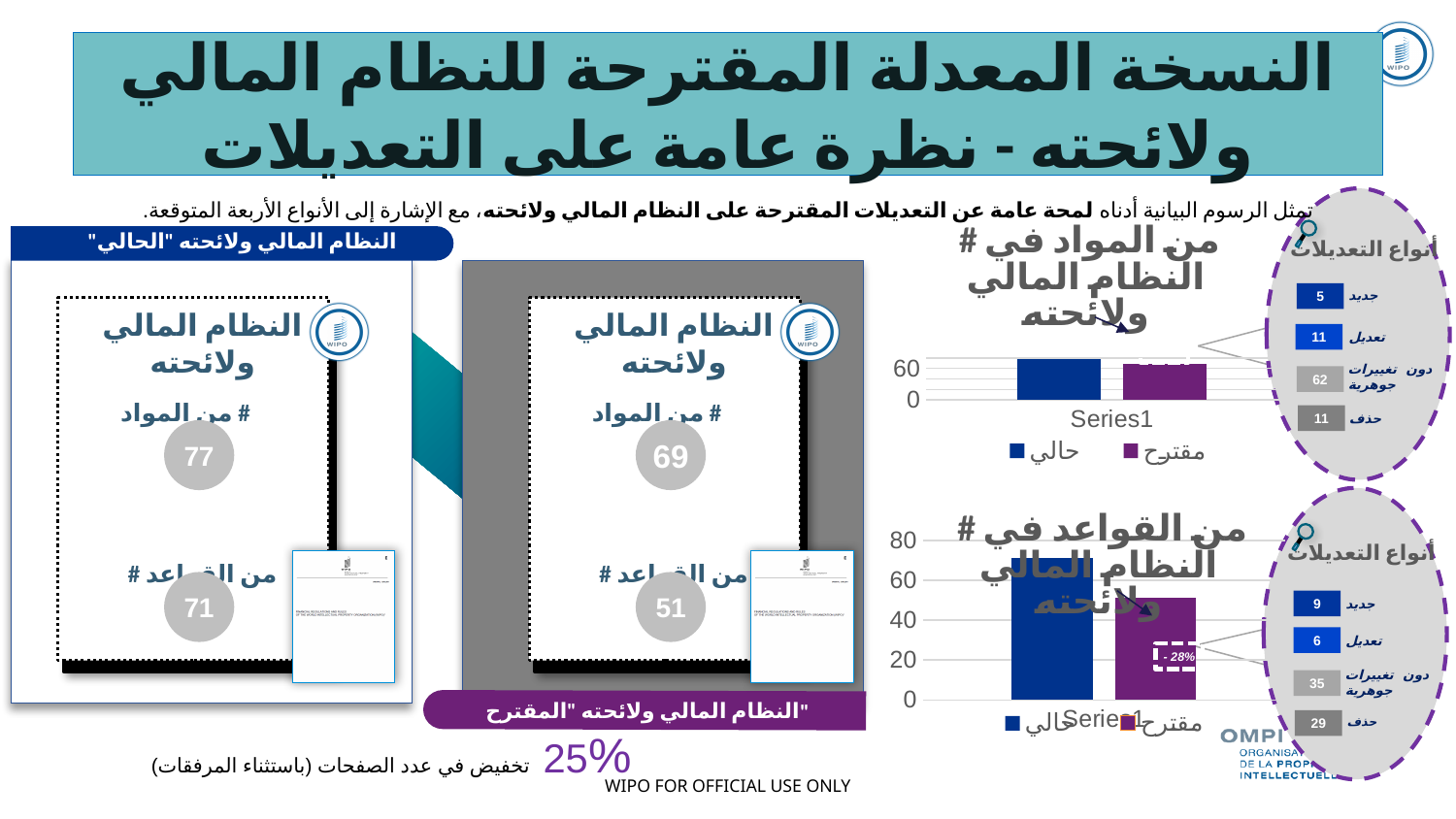
In the bottom chart (# من القواعد في النظام المالي ولائحته), what percentage change is labelled on the مقترح bar? -28% In the bottom chart (# من القواعد في النظام المالي ولائحته), is the value for حالي greater or less than 60? greater In the bottom chart (# من القواعد في النظام المالي ولائحته), which series has the taller bar, حالي or مقترح? حالي In the bottom chart (# من القواعد في النظام المالي ولائحته), what colour is the bar for حالي? blue In the bottom chart (# من القواعد في النظام المالي ولائحته), how many series does the legend list? 2 In the top chart (# من المواد في النظام المالي ولائحته), what are the two legend entries? حالي and مقترح What kind of chart is the bottom chart on the right (# من القواعد في النظام المالي ولائحته)? bar chart In the top chart (# من المواد في النظام المالي ولائحته), is the value for حالي greater or less than 60? greater What kind of chart is the top chart on the right (# من المواد في النظام المالي ولائحته)? bar chart In the top chart (# من المواد في النظام المالي ولائحته), how many series does the legend list? 2 In the bottom chart (# من القواعد في النظام المالي ولائحته), is the value for مقترح greater or less than 60? less